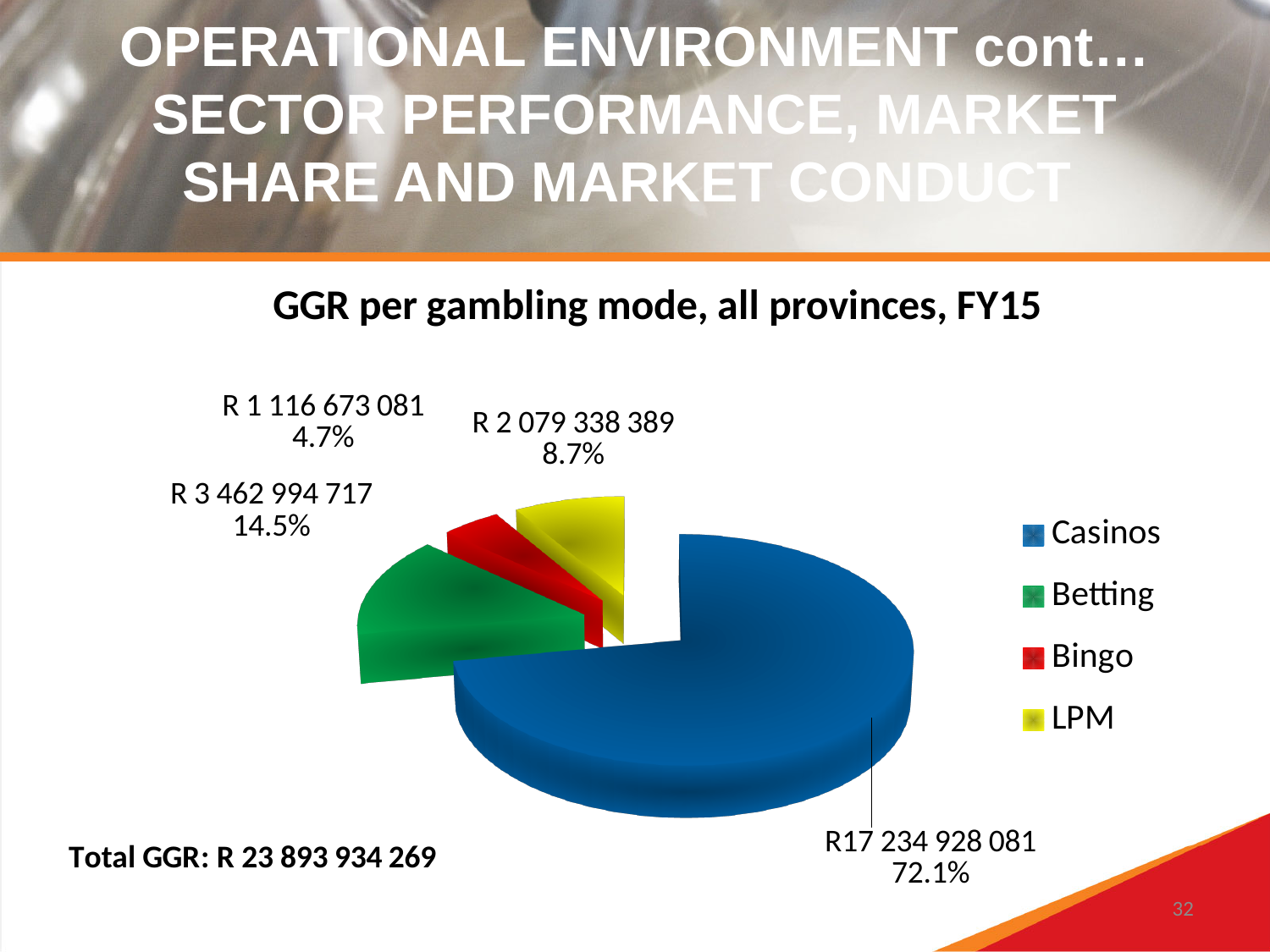
Which has a larger share of GGR, Betting or LPM? Betting What is the GGR value for Casinos? R17 234 928 081 What share of GGR does LPM account for? 8.7% What share of GGR does Betting account for? 14.5% How many slices does the pie chart have? 4 What is the GGR value for Bingo? R 1 116 673 081 How many gambling modes does the legend list? 4 What kind of chart is shown on the slide? pie chart Which gambling mode has the smallest share of GGR? Bingo What share of GGR do Casinos account for? 72.1% Which gambling mode has the largest share of GGR? Casinos What is the title of the chart? GGR per gambling mode, all provinces, FY15